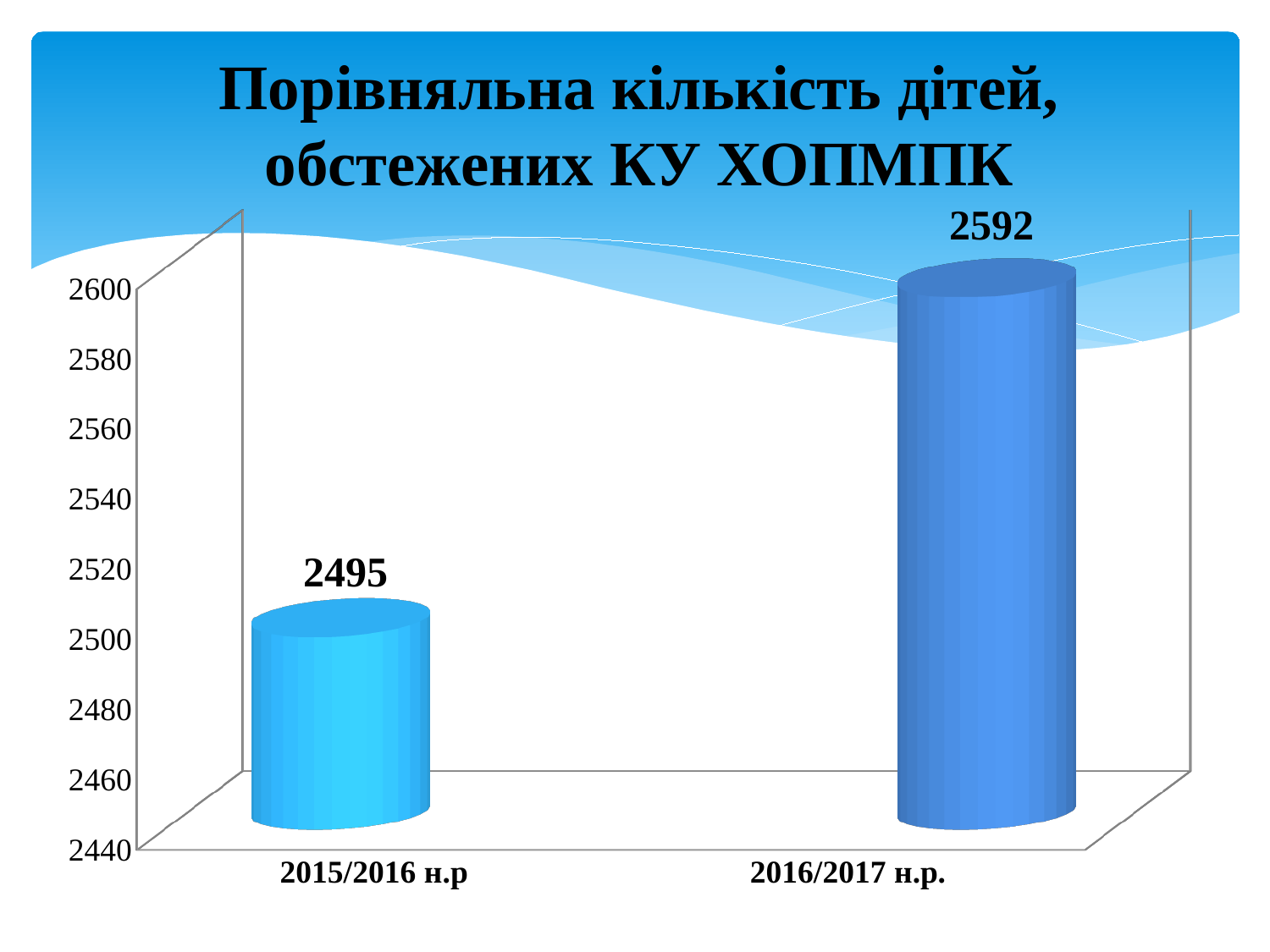
What is the title of the chart? Порівняльна кількість дітей, обстежених КУ ХОПМПК What is the value for 2015/2016 н.р? 2495 Which category has the highest value? 2016/2017 н.р. Is the value for 2015/2016 н.р greater or less than 2500? less Is the value for 2016/2017 н.р. greater or less than 2580? greater What kind of chart is shown on the slide? bar chart Do the values rise or fall from 2015/2016 н.р to 2016/2017 н.р.? rise Which category has the lowest value? 2015/2016 н.р What is the value for 2016/2017 н.р.? 2592 Which is larger, the value for 2015/2016 н.р or the value for 2016/2017 н.р.? 2016/2017 н.р. What is the difference between the values for 2016/2017 н.р. and 2015/2016 н.р? 97 How many categories are shown on the chart? 2